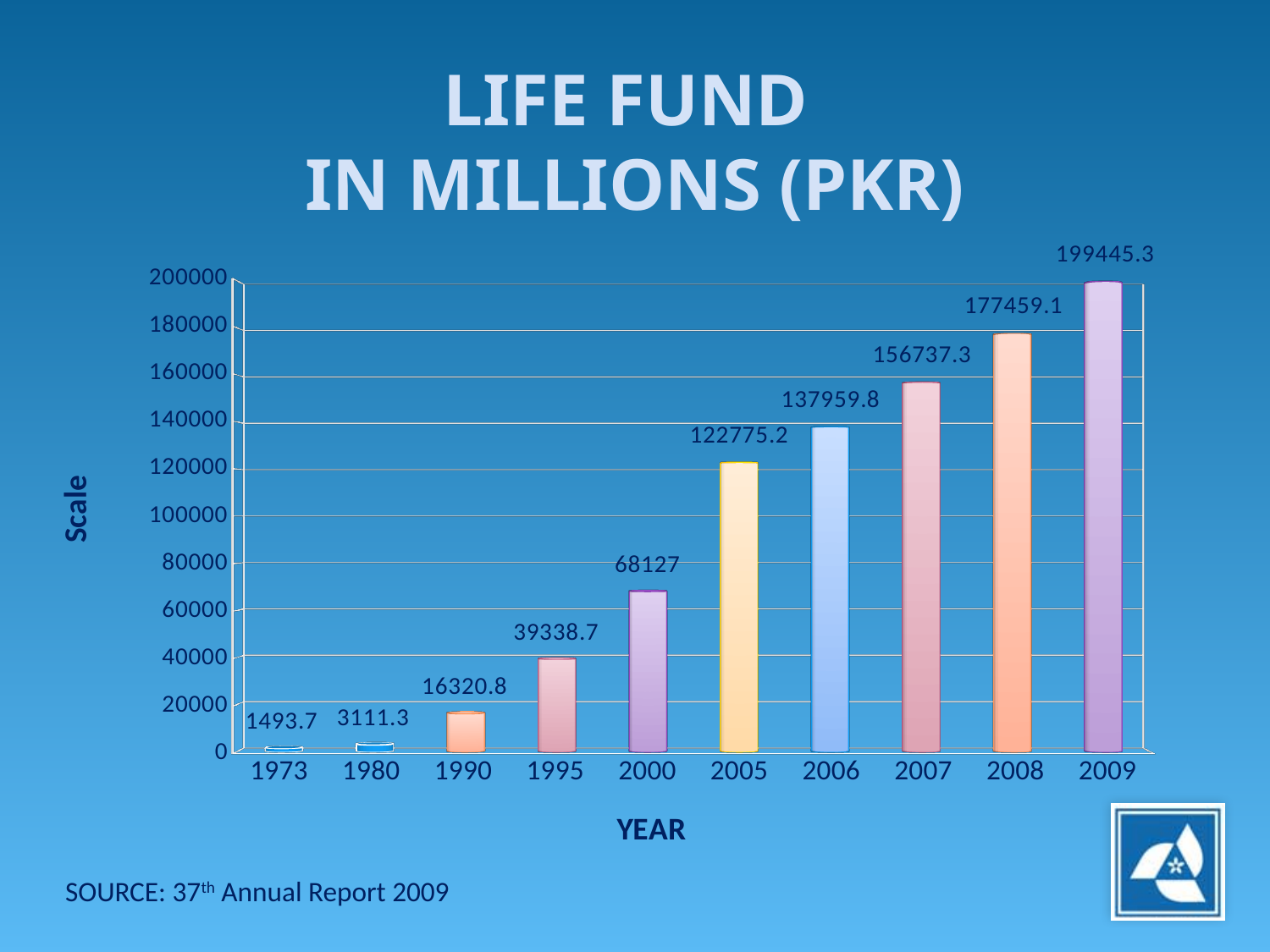
What is the difference between the life fund values for 1980 and 1973? 1617.6 Which year has the lowest life fund value? 1973 What is the life fund value for 2005? 122775.2 Which year has the highest life fund value? 2009 What is the difference between the life fund values for 2009 and 2008? 21986.2 What is the life fund value for 1990? 16320.8 How many years are shown on the x axis? 10 Do the life fund values rise or fall from 1973 to 2009? rise Is the value for 1995 greater or less than 40000? less What is the life fund value for 2000? 68127 What kind of chart is shown on the slide? bar chart Which is larger, the life fund value for 2006 or for 2007? 2007